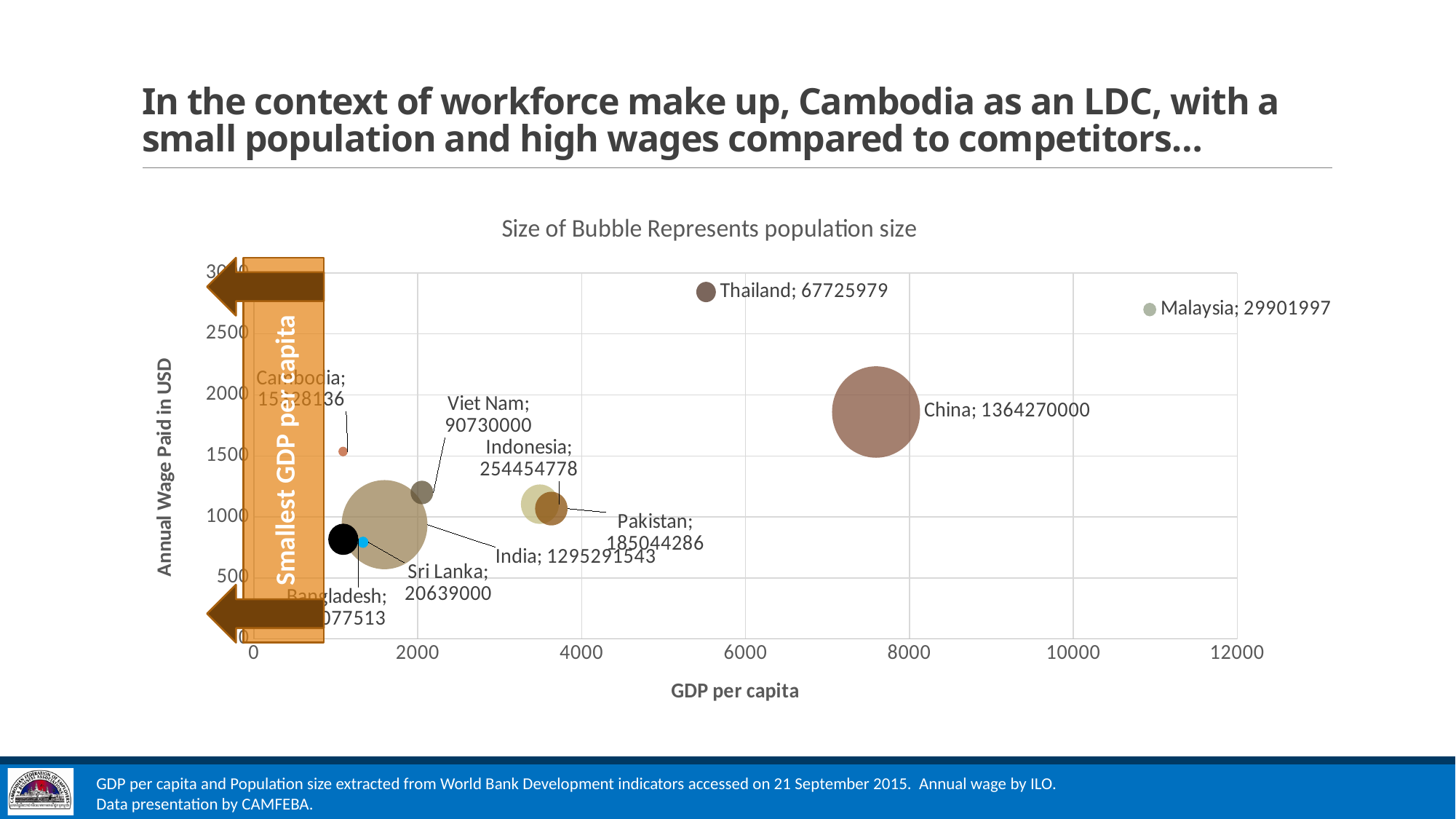
What population size is shown for India? 1295291543 What population size is shown for Sri Lanka? 20639000 Which has the larger population, China or India? China Is the annual wage for China greater or less than 1500? greater What population size is shown for China? 1364270000 What kind of chart is shown on the slide? bubble chart What population size is shown for Indonesia? 254454778 What population size is shown for Malaysia? 29901997 Which country has the largest population shown on the chart? China Is the GDP per capita for Malaysia greater or less than 10000? greater What is the difference between the populations shown for China and India? 68978457 What population size is shown for Thailand? 67725979